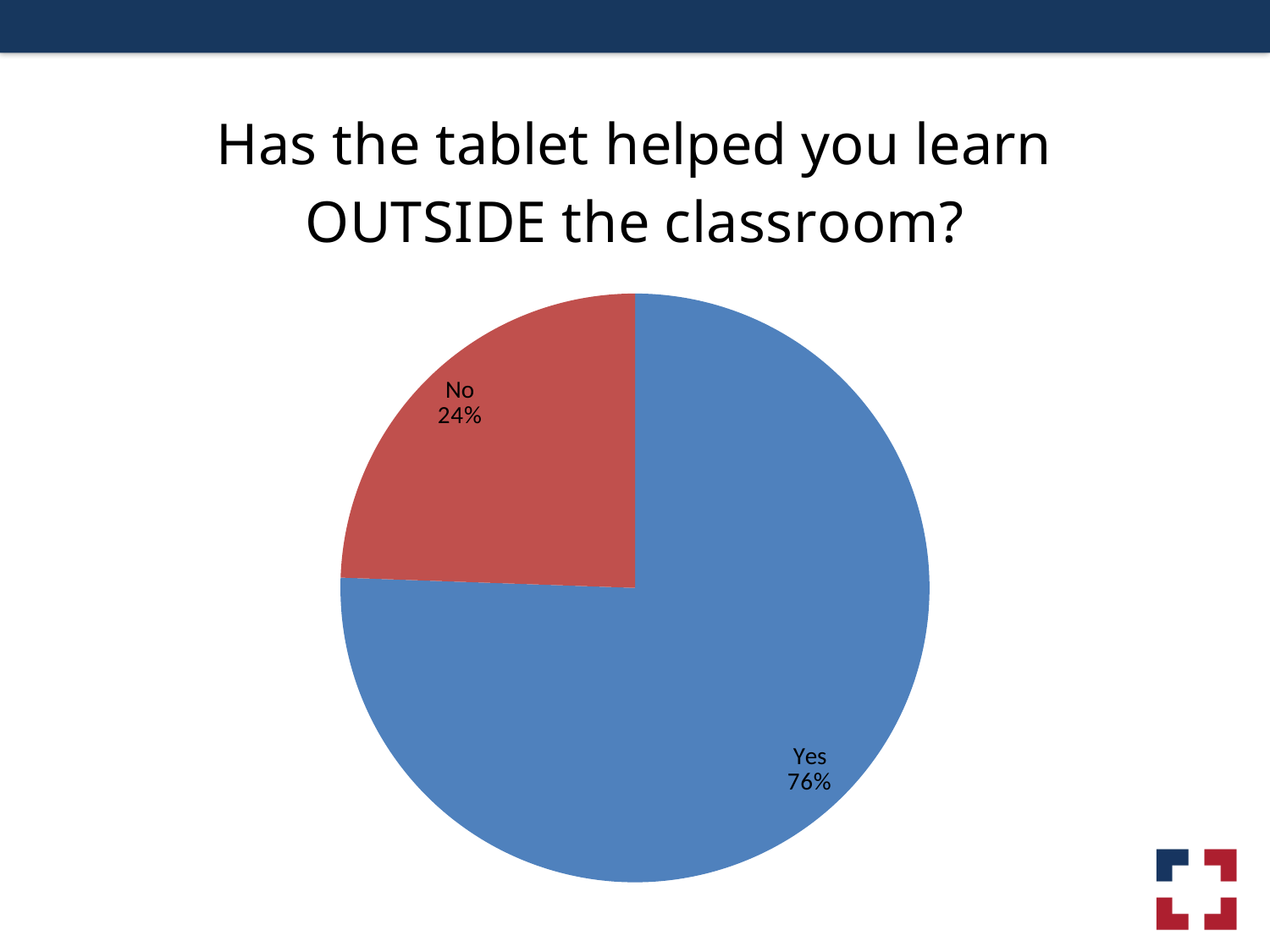
What share of the pie does the No slice represent? 24% What is the difference in percentage points between the Yes and No slices? 52 How many slices does the pie chart have? 2 Which response has the largest share of the pie? Yes What percentage of respondents answered No? 24% What percentage of respondents answered Yes? 76% What colour is the Yes slice? blue Which slice is larger, Yes or No? Yes Which response has the smallest share of the pie? No What kind of chart is shown on the slide? pie chart What is the title of the chart? Has the tablet helped you learn OUTSIDE the classroom?